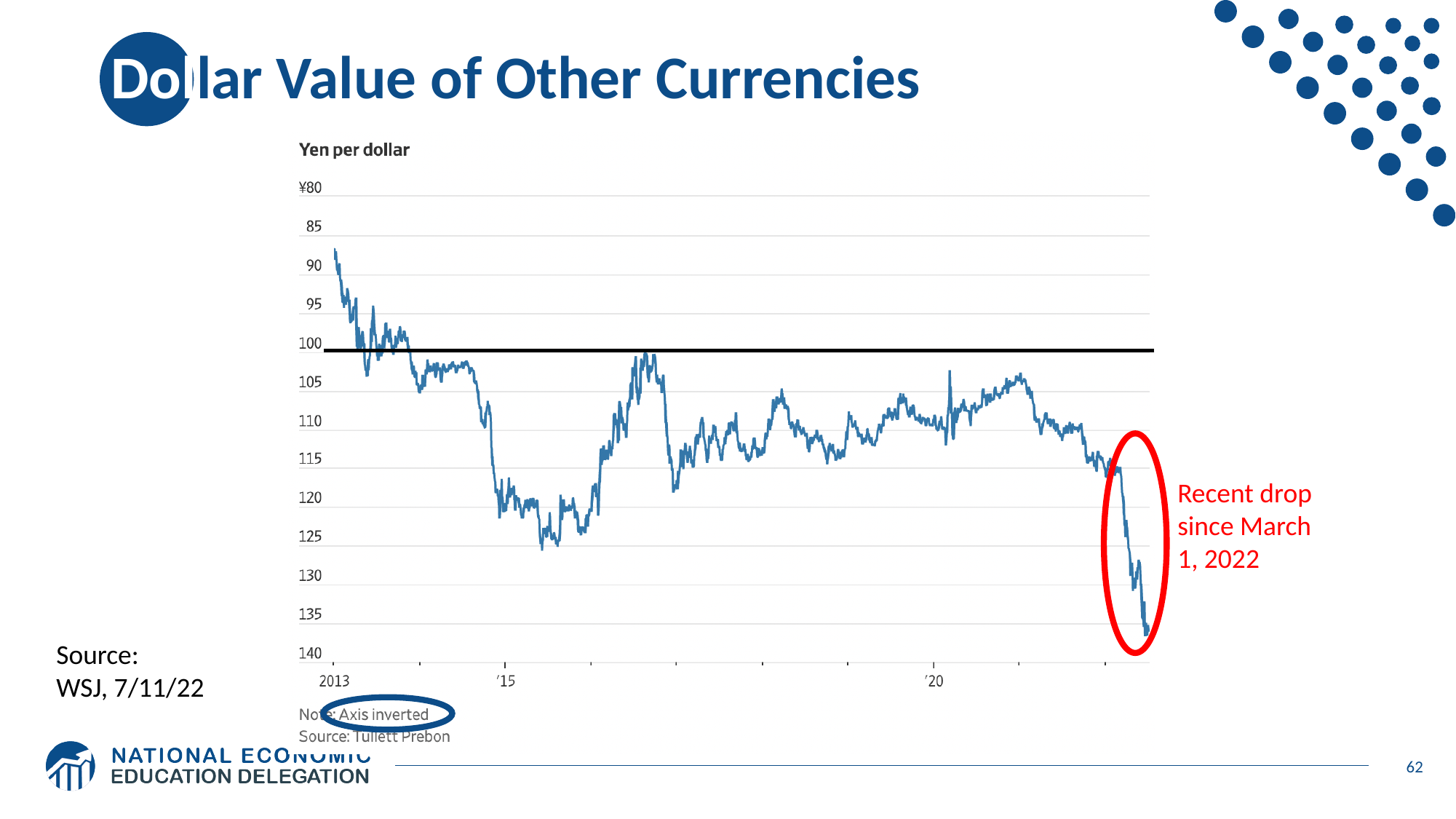
Is the yen-per-dollar value at the right-hand end of the line (mid-2022) greater or less than 130? greater Is the lowest point of the line (around 2016) greater or less than 120 yen per dollar? greater Comparing the start of the line in 2013 with its end in 2022, does the yen-per-dollar value rise or fall? rise Does the yen-per-dollar value rise or fall over the period circled in red (since March 1, 2022)? rise At which y-axis value is the thick black horizontal line drawn across the chart? 100 What quantity does the y axis of the chart measure, according to its label? Yen per dollar What is the first year labelled on the x axis of the chart? 2013 Is the yen-per-dollar value at the '15 tick mark greater or less than 110? greater What kind of chart is shown on the slide? Line chart What does the note beneath the chart say about the axis? Axis inverted How many data series are plotted on the chart? 1